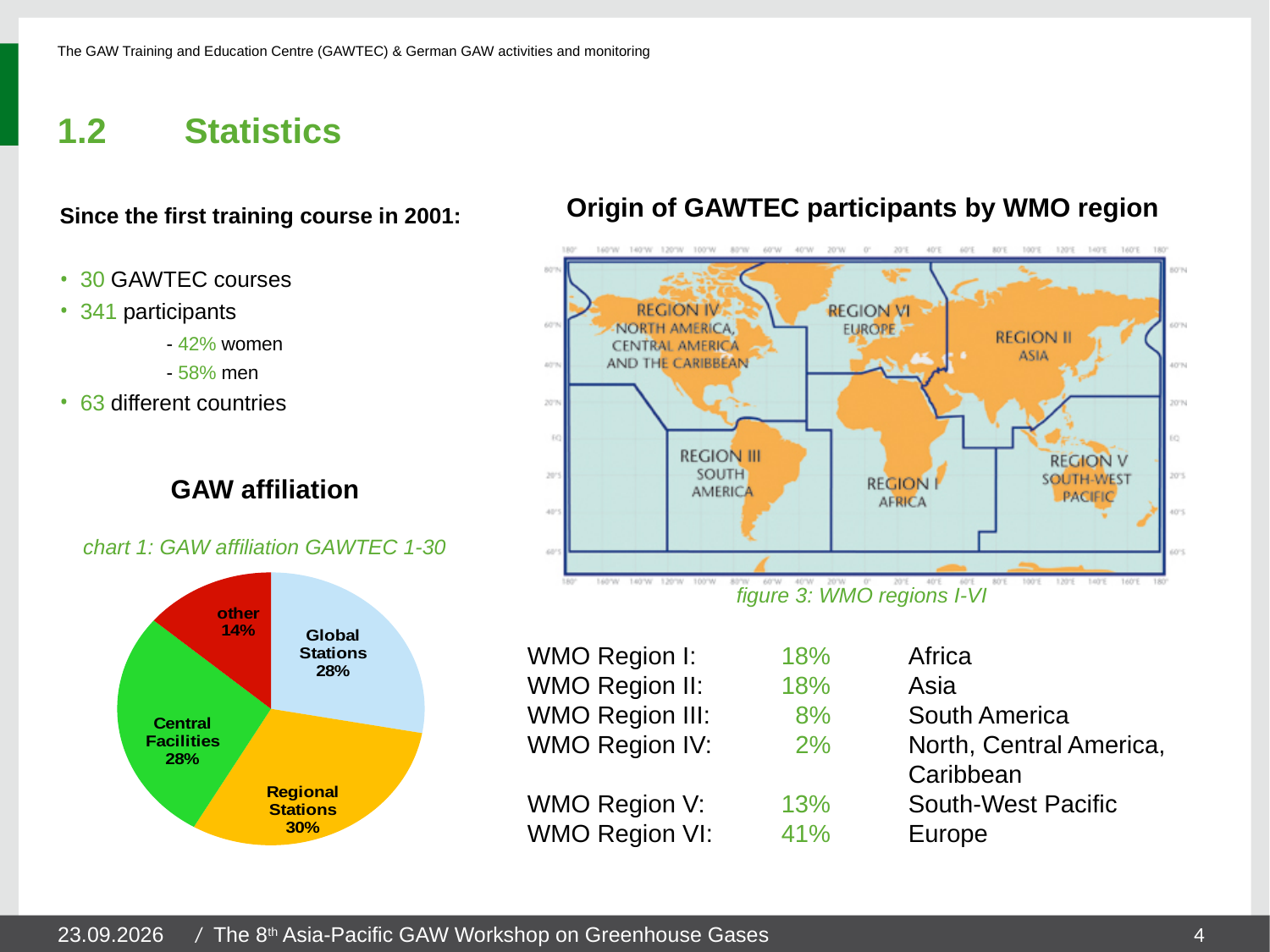
In the GAW affiliation pie chart, what share is labelled 'other'? 14% In the GAW affiliation pie chart, what share do Central Facilities have? 28% In the GAW affiliation pie chart, which is larger: Regional Stations or Global Stations? Regional Stations In the GAW affiliation pie chart, what share do Regional Stations have? 30% What is the caption of the pie chart on the slide? chart 1: GAW affiliation GAWTEC 1-30 How many slices does the GAW affiliation pie chart have? 4 In the GAW affiliation pie chart, what share do Global Stations have? 28% What kind of chart is chart 1 (GAW affiliation GAWTEC 1-30)? pie chart In the GAW affiliation pie chart, what is the difference between the Regional Stations share and the 'other' share? 16% Which slice of the GAW affiliation pie chart is the smallest? other In the GAW affiliation pie chart, what is the combined share of Global Stations and Central Facilities? 56% Which slice of the GAW affiliation pie chart is the largest? Regional Stations